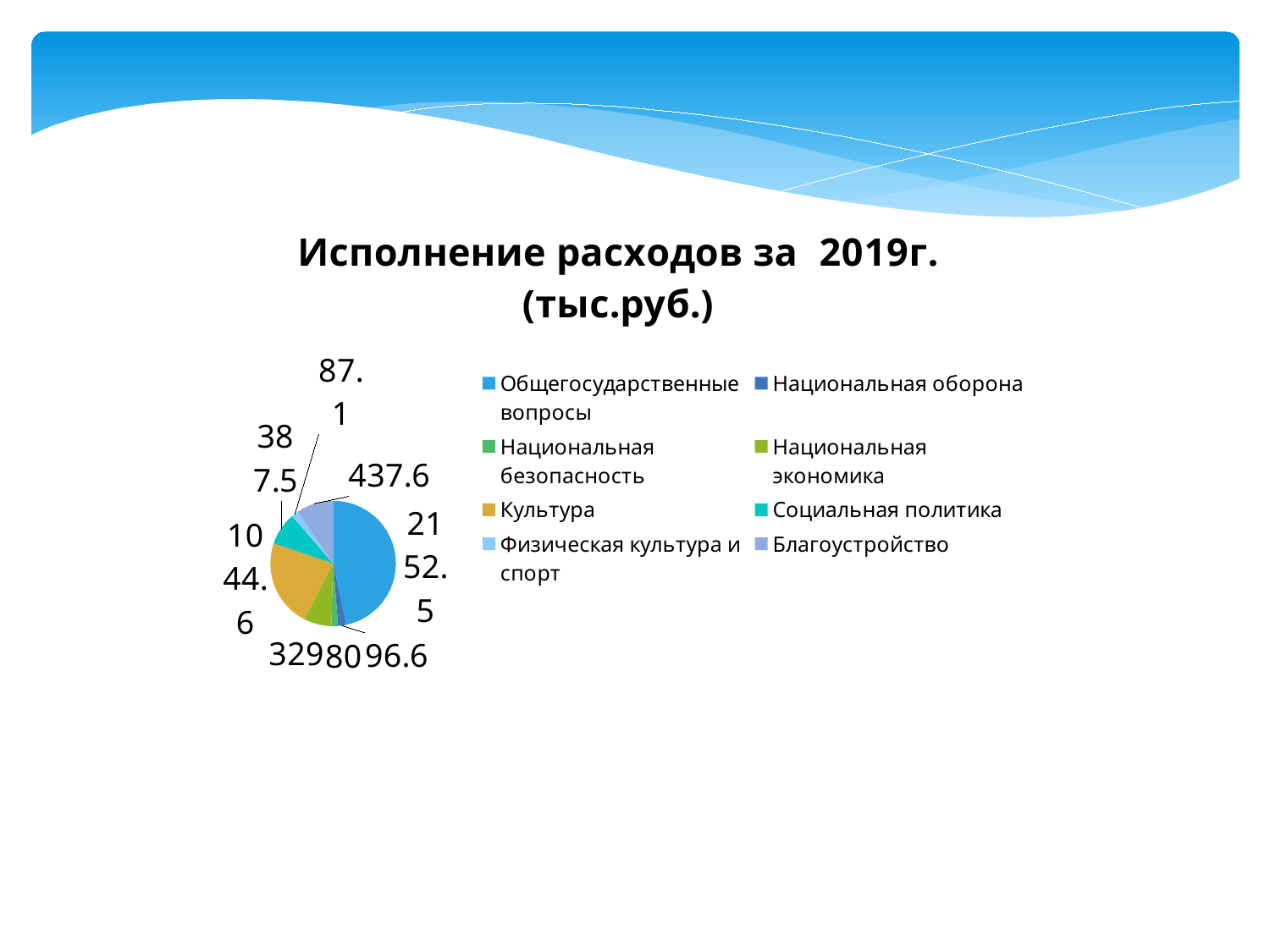
What value is labelled on the slice for Общегосударственные вопросы? 2152.5 Which category has the largest slice of the pie? Общегосударственные вопросы Which is larger: the slice for Общегосударственные вопросы or the slice for Культура? Общегосударственные вопросы Which is larger: the slice for Национальная экономика or the slice for Национальная безопасность? Национальная экономика Which category has the smallest slice of the pie? Национальная безопасность What is the title of the chart? Исполнение расходов за 2019г. (тыс.руб.) Which is larger: the slice for Культура or the slice for Национальная оборона? Культура How many categories does the legend of the pie chart list? 8 What colour is the slice for Культура? gold What kind of chart is shown on the slide? pie chart